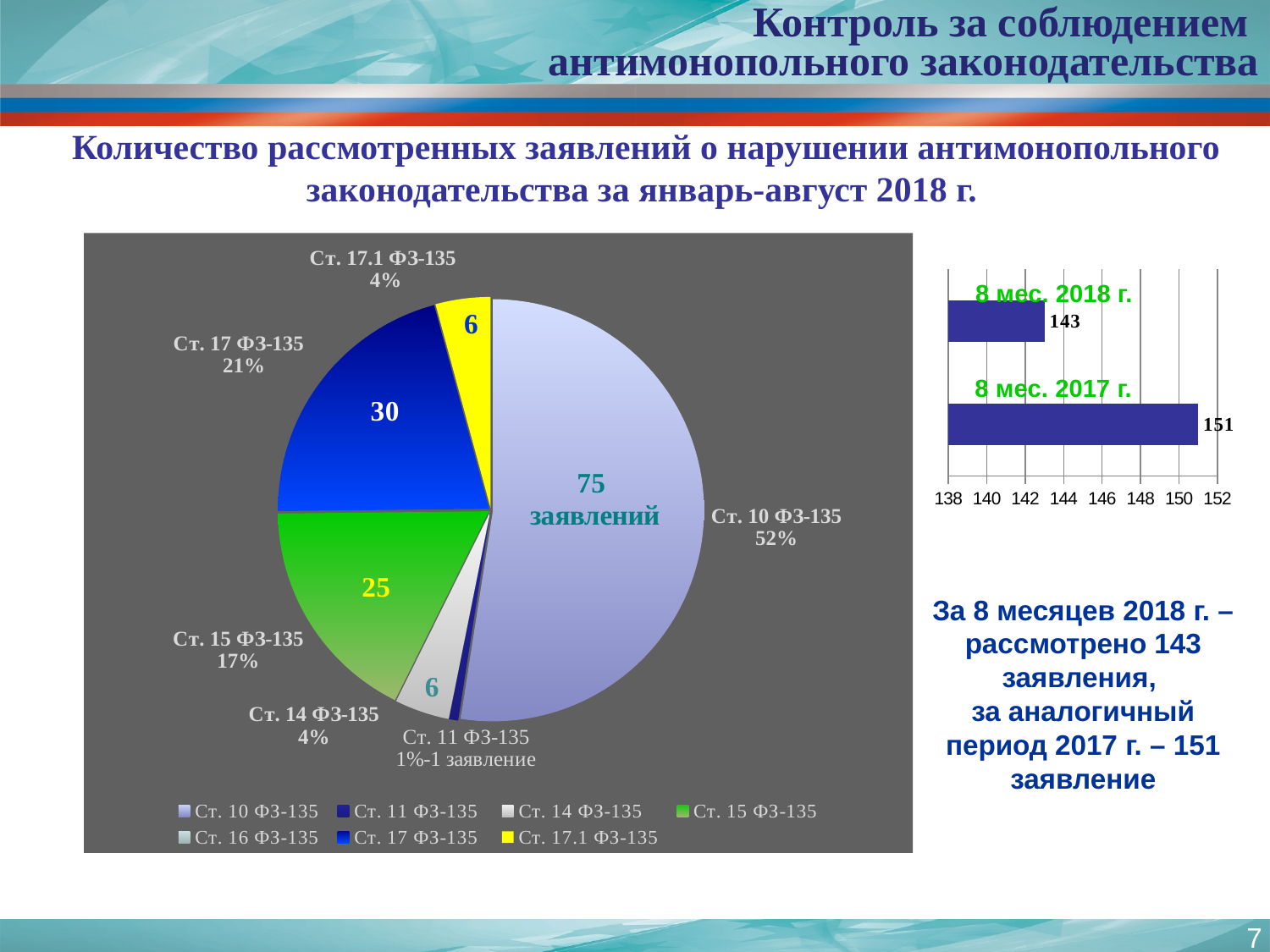
On the pie chart, how many entries does the legend list? 7 On the pie chart, what is the difference in applications between Ст. 17 ФЗ-135 and Ст. 15 ФЗ-135? 5 On the pie chart, how many applications are shown for Ст. 17 ФЗ-135? 30 On the bar chart on the right, what is the difference between the values for 8 мес. 2017 г. and 8 мес. 2018 г.? 8 On the pie chart, what share of applications is for Ст. 10 ФЗ-135? 52% What type of chart is the chart on the right side of the slide? Bar chart On the pie chart, which category has the smallest labelled share? Ст. 11 ФЗ-135 On the bar chart on the right, which period has the larger value, 8 мес. 2017 г. or 8 мес. 2018 г.? 8 мес. 2017 г. On the pie chart, which category has the largest share? Ст. 10 ФЗ-135 On the bar chart on the right, what is the value for 8 мес. 2018 г.? 143 On the pie chart, what share of applications is for Ст. 17.1 ФЗ-135? 4% On the pie chart, how many applications are shown for Ст. 15 ФЗ-135? 25